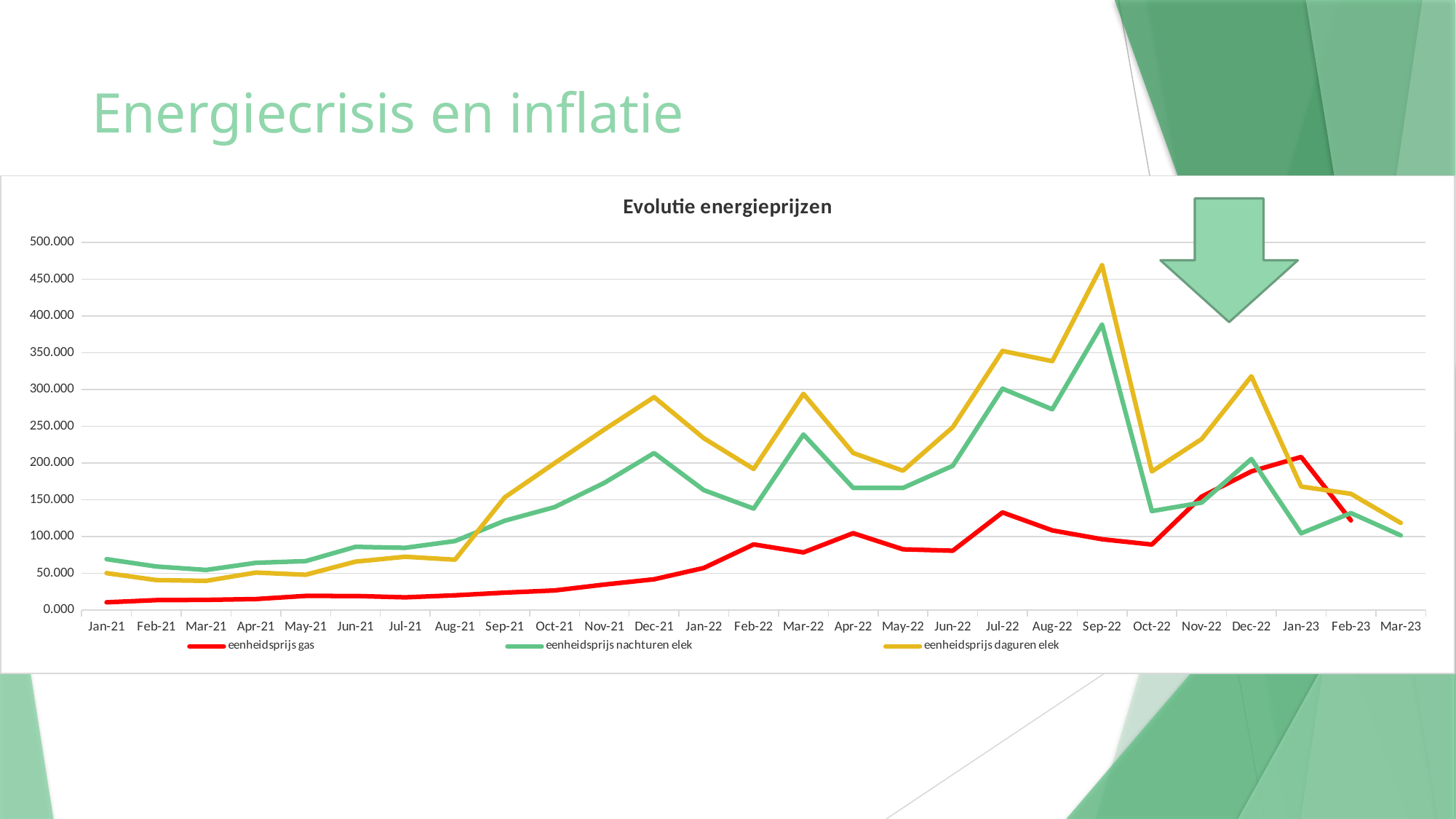
In which month does the 'eenheidsprijs daguren elek' series reach its highest value? Sep-22 How many series does the legend list? 3 Is the value for 'eenheidsprijs gas' in Jan-21 greater or less than 50.000? less In which month does the 'eenheidsprijs nachturen elek' series reach its highest value? Sep-22 In which month does the 'eenheidsprijs gas' series reach its highest value? Jan-23 Is the value for 'eenheidsprijs nachturen elek' in Sep-22 greater or less than 350.000? greater How many months are shown along the x axis? 27 In Jan-23, which is larger: 'eenheidsprijs gas' or 'eenheidsprijs nachturen elek'? eenheidsprijs gas What kind of chart is shown on the slide? line chart What is the title of the chart? Evolutie energieprijzen Is the value for 'eenheidsprijs daguren elek' in Sep-22 greater or less than 450.000? greater Does the 'eenheidsprijs daguren elek' series rise or fall from Sep-22 to Oct-22? fall